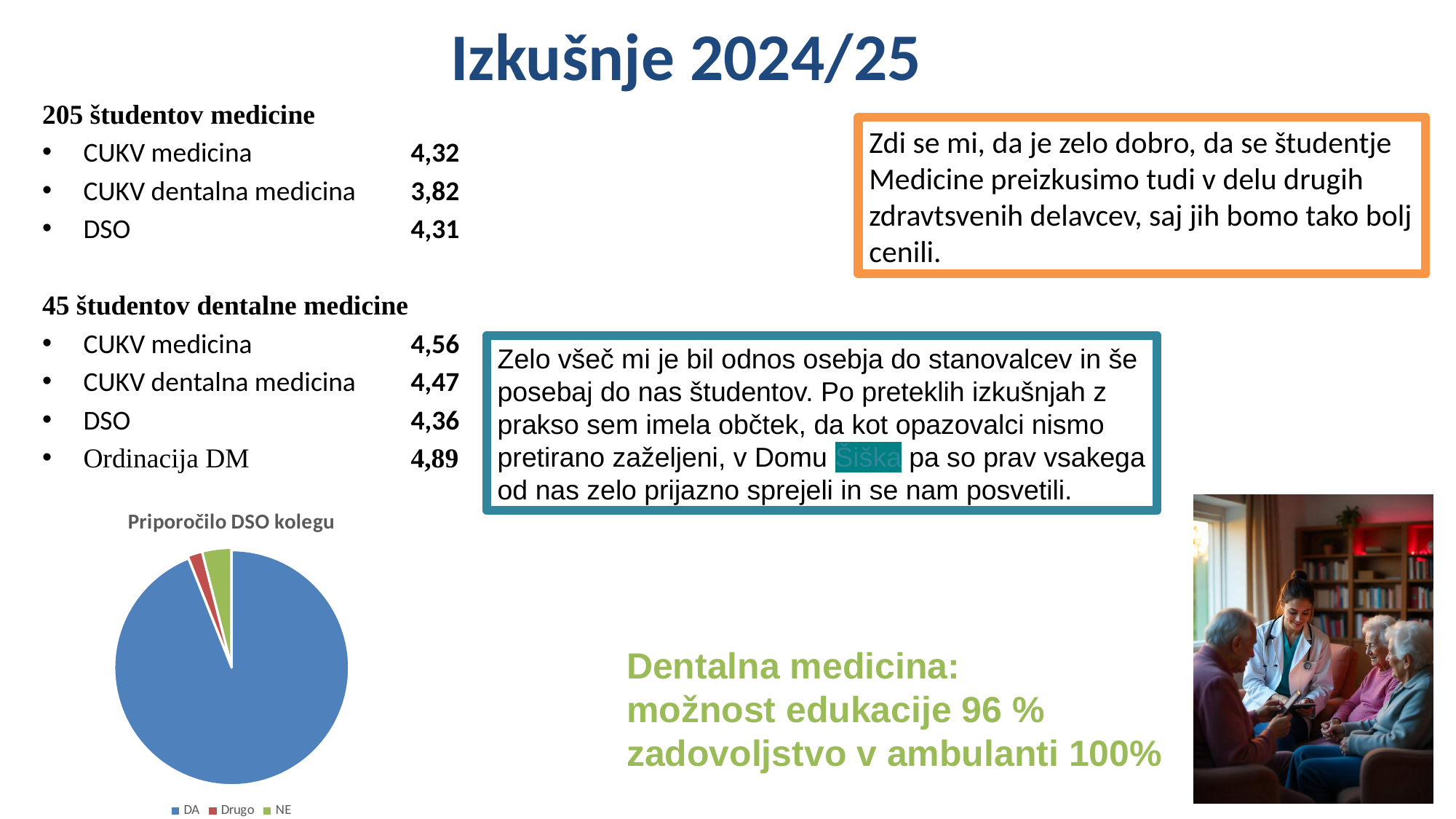
In the pie chart "Priporočilo DSO kolegu", which slice is larger, NE or Drugo? NE Which legend entries are listed for the pie chart "Priporočilo DSO kolegu"? DA, Drugo, NE What kind of chart is shown under the title "Priporočilo DSO kolegu"? pie chart What is the title of the pie chart on the slide? Priporočilo DSO kolegu What colour is the DA slice in the pie chart "Priporočilo DSO kolegu"? blue How many slices does the pie chart "Priporočilo DSO kolegu" have? 3 Which category has the largest slice in the pie chart "Priporočilo DSO kolegu"? DA Which category has the smallest slice in the pie chart "Priporočilo DSO kolegu"? Drugo In the pie chart "Priporočilo DSO kolegu", which slice is larger, DA or NE? DA How many entries does the legend of the pie chart list? 3